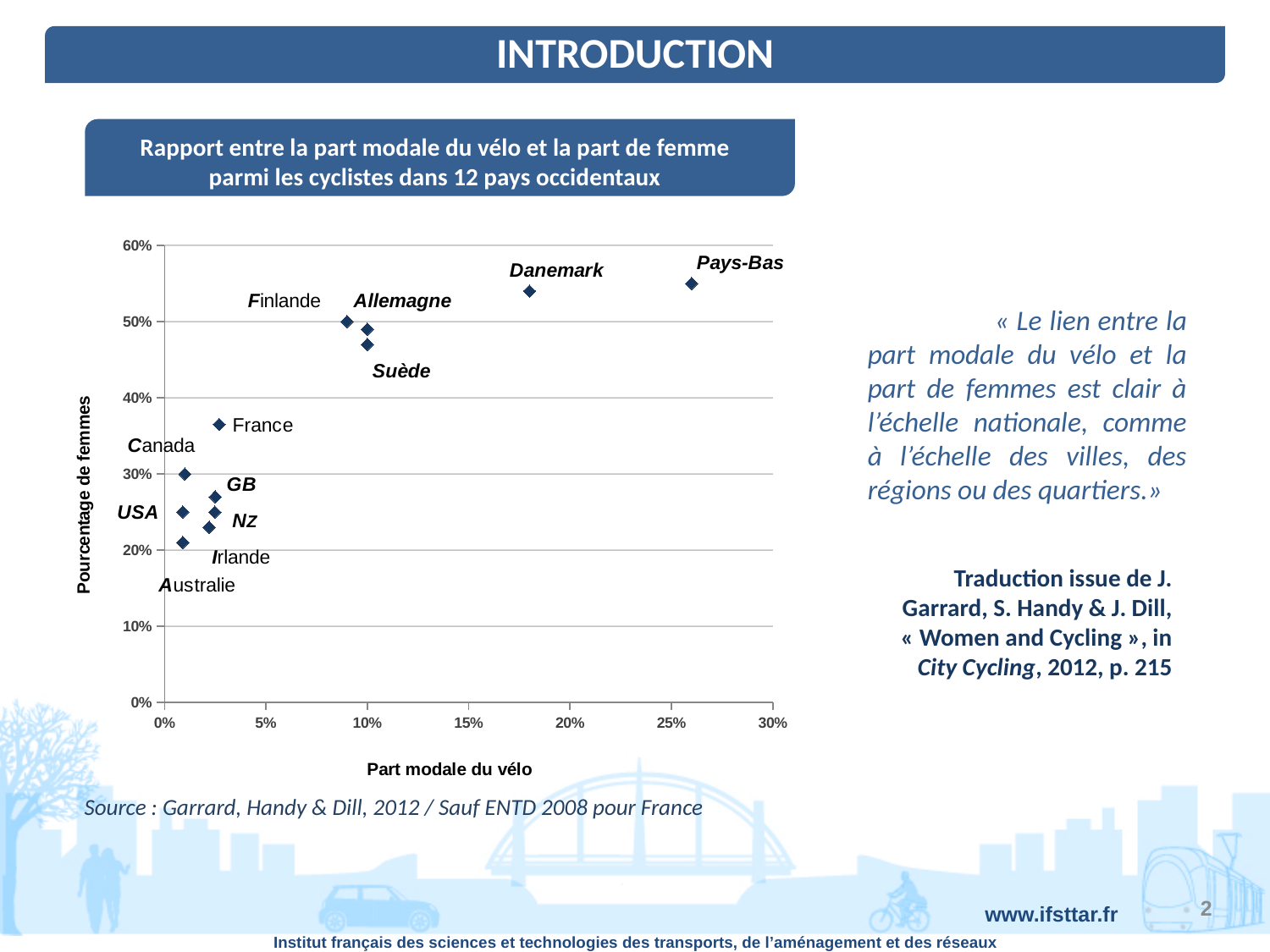
Which has a higher percentage of women, Danemark or France? Danemark What kind of chart is shown on the slide? Scatter chart What is the title of the x axis of the chart? Part modale du vélo Is the percentage of women for France greater or less than 40%? less Which country has the highest bicycle modal share (Part modale du vélo) on the chart? Pays-Bas Is the percentage of women (Pourcentage de femmes) for Danemark greater or less than 50%? greater As the bicycle modal share increases along the x axis, does the percentage of women generally rise or fall? rise Is the bicycle modal share for Danemark greater or less than 20%? less How many countries are plotted on the chart? 12 Which has a higher bicycle modal share, Pays-Bas or Danemark? Pays-Bas